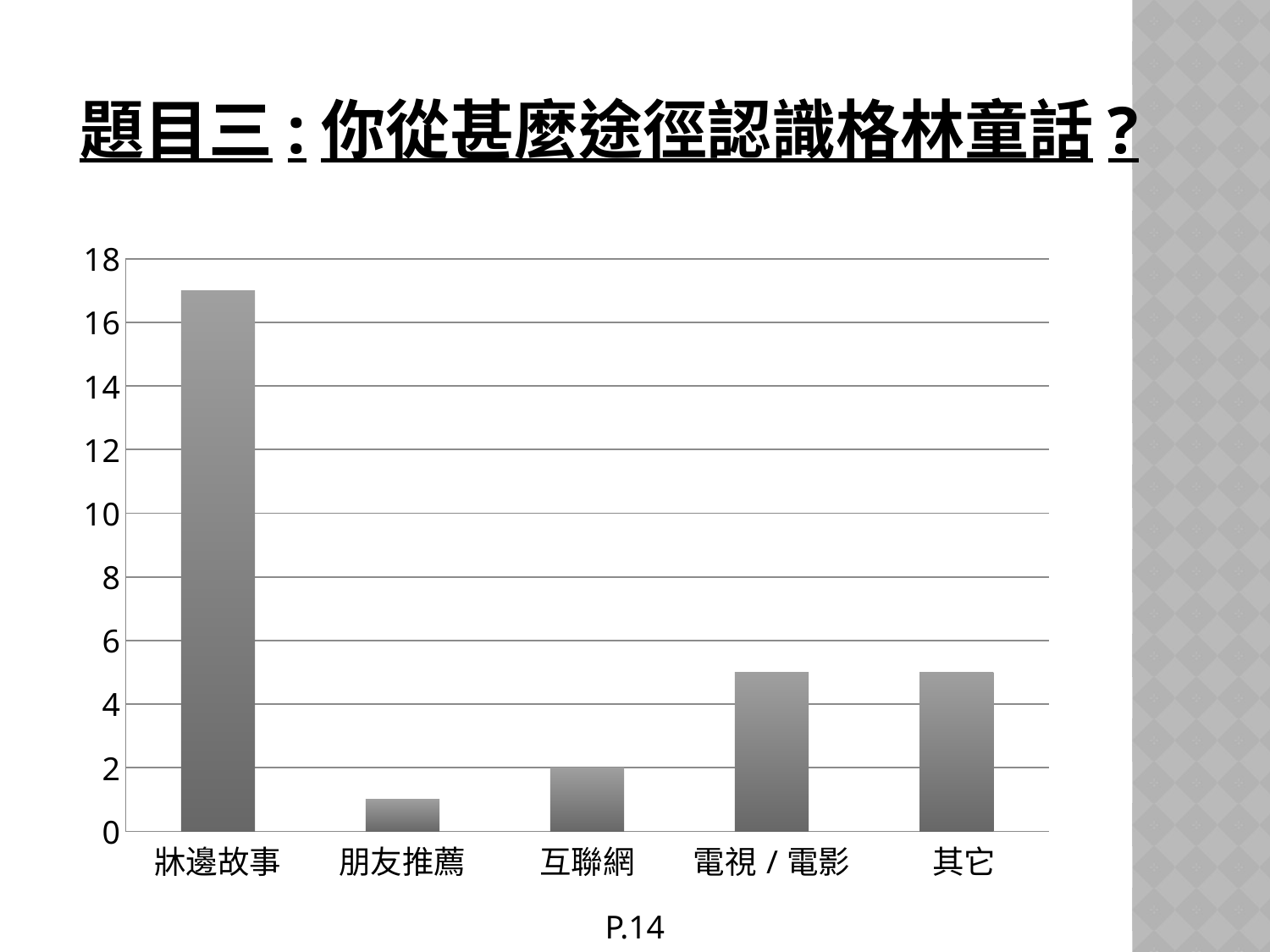
Which category has the lowest value in the chart? 朋友推薦 How many categories are shown on the x axis of the chart? 5 Is the value for 朋友推薦 greater or less than 2? less Which is larger, the value for 互聯網 or the value for 電視／電影? 電視／電影 Is the value for 其它 greater or less than 6? less What kind of chart is shown on the slide? bar chart Which is larger, the value for 牀邊故事 or the value for 其它? 牀邊故事 Which category has the highest value in the chart? 牀邊故事 What is the value for 互聯網? 2 What is the title of the slide above the chart? 題目三 : 你從甚麼途徑認識格林童話？ Is the value for 電視／電影 greater or less than 4? greater